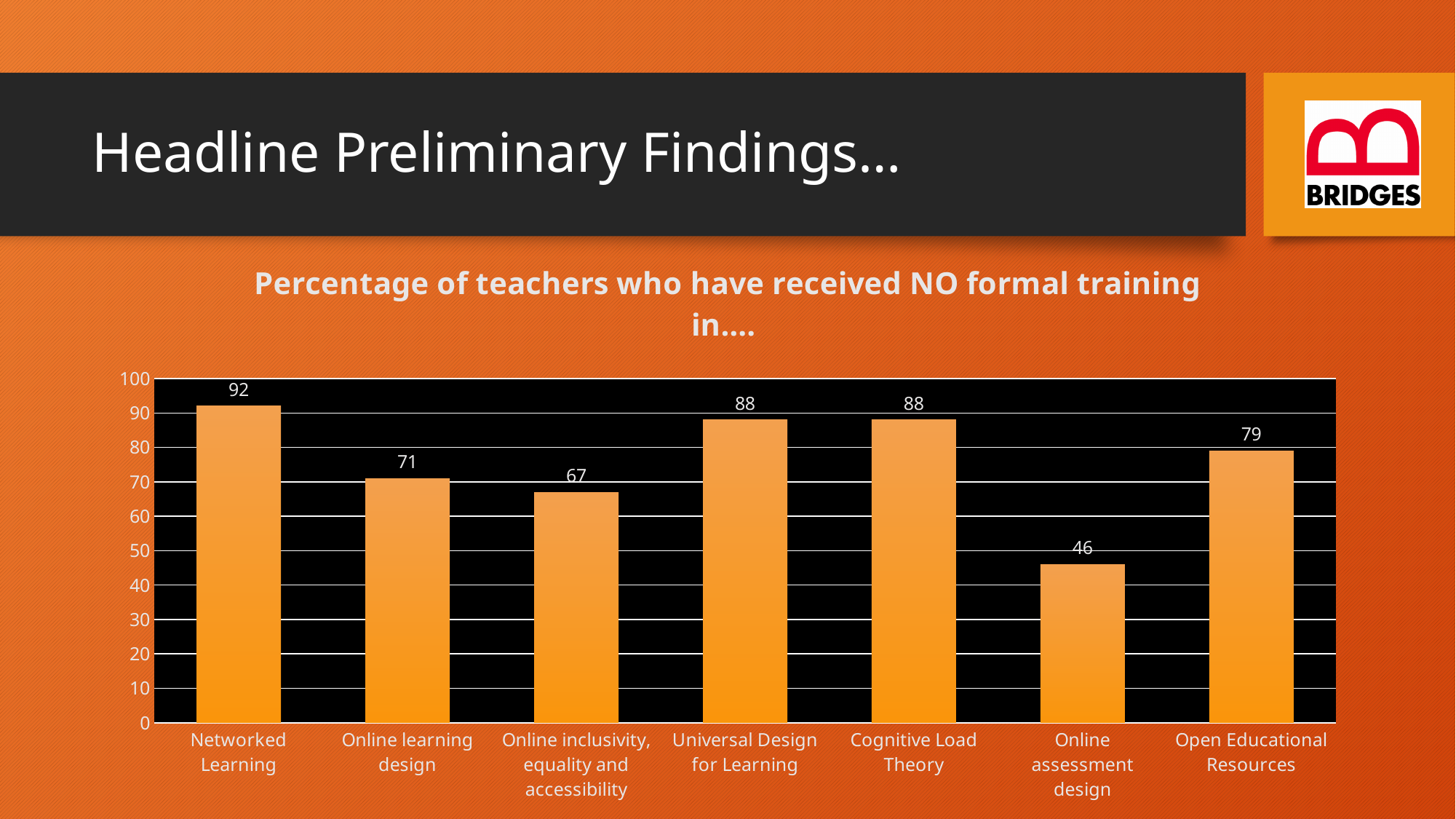
What is the difference between the values for Online learning design and Online inclusivity, equality and accessibility? 4 What is the title of the chart? Percentage of teachers who have received NO formal training in…. What is the difference between the values for Networked Learning and Online assessment design? 46 What is the value for Networked Learning? 92 What kind of chart is shown on the slide? bar chart What is the value for Open Educational Resources? 79 What is the value for Online assessment design? 46 Which category has the highest value? Networked Learning Which is larger, the value for Open Educational Resources or the value for Online learning design? Open Educational Resources Which category has the lowest value? Online assessment design Is the value for Cognitive Load Theory greater or less than 80? greater How many categories are shown on the x axis? 7